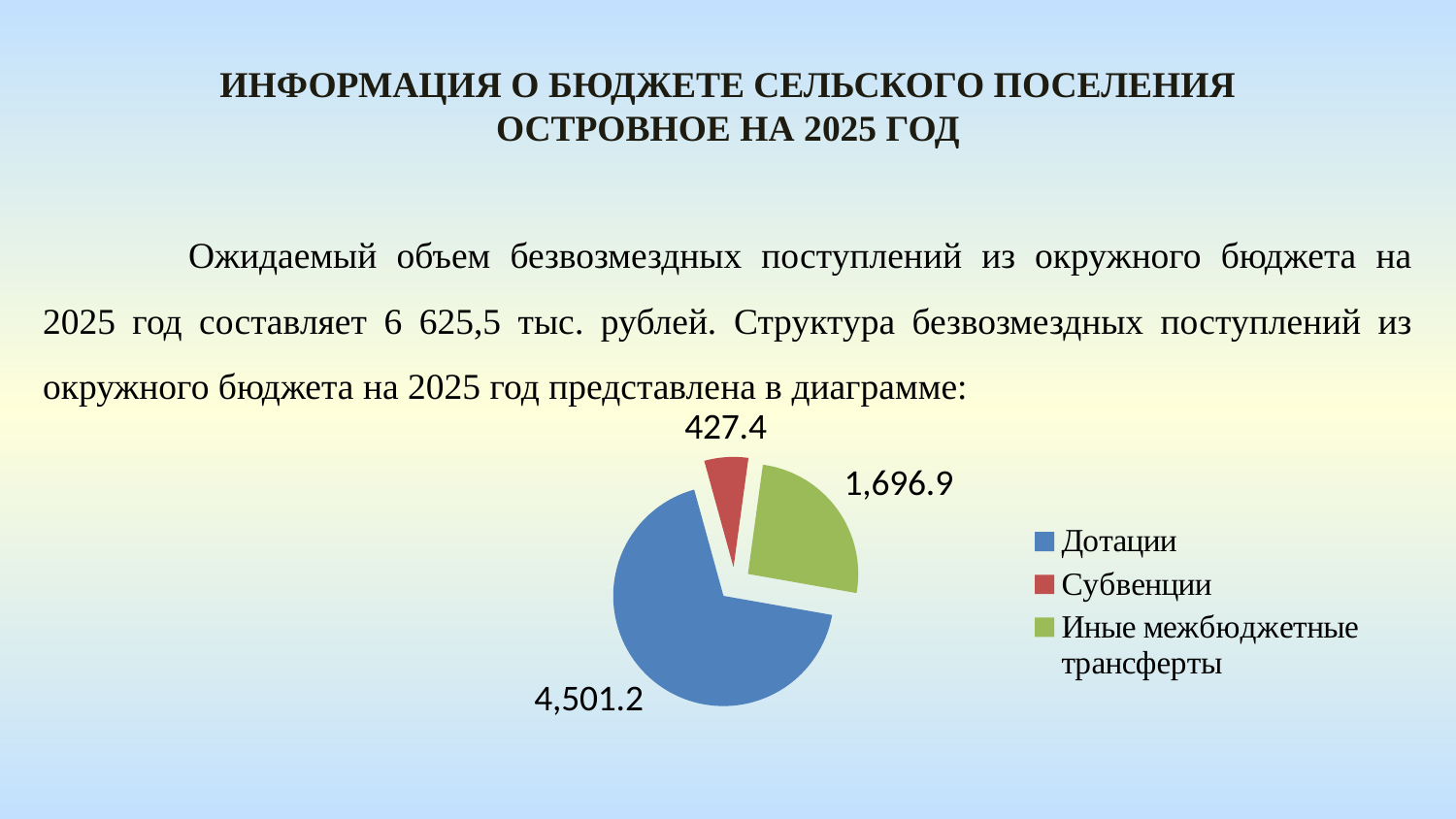
What is the difference between the values for Дотации and Субвенции? 4,073.8 What is the difference between the values for Иные межбюджетные трансферты and Субвенции? 1,269.5 What colour is the slice for Субвенции? red What is the value for Дотации in the pie chart? 4,501.2 What type of chart is shown on the slide? pie chart Which category has the smallest slice in the pie chart? Субвенции Which category has the largest slice in the pie chart? Дотации What is the total of all slices in the pie chart? 6,625.5 How many slices does the pie chart have? 3 Which is larger, the value for Иные межбюджетные трансферты or the value for Субвенции? Иные межбюджетные трансферты What is the value for Иные межбюджетные трансферты in the pie chart? 1,696.9 What is the value for Субвенции in the pie chart? 427.4